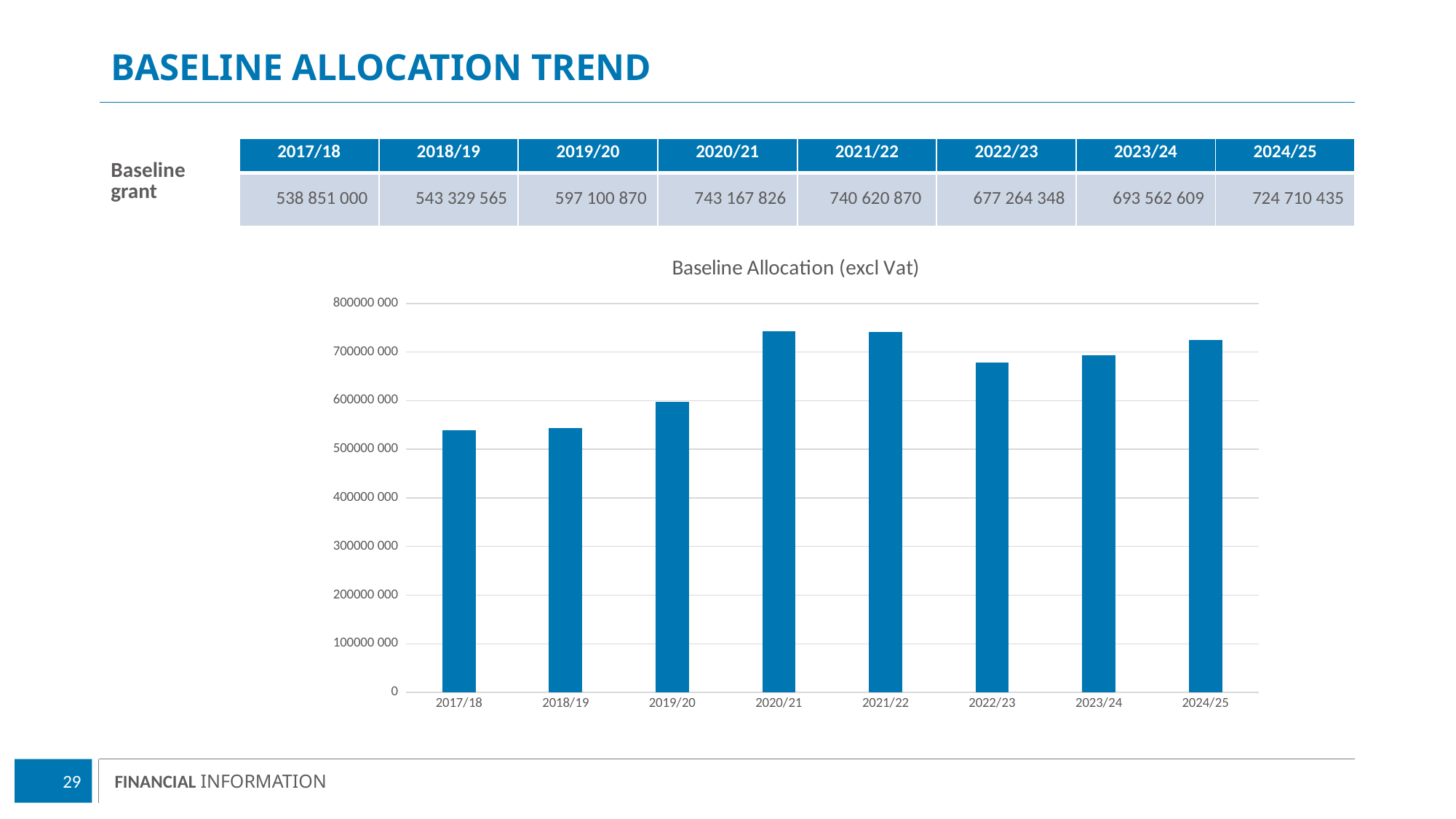
What is the baseline grant value for 2019/20? 597 100 870 Which year has the lowest baseline allocation? 2017/18 What is the difference between the baseline allocation for 2024/25 and 2023/24? 31 147 826 Which is larger, the baseline allocation for 2022/23 or for 2023/24? 2023/24 How many years are shown on the chart? 8 Is the value for 2022/23 greater or less than 700000 000? less What is the title of the chart? Baseline Allocation (excl Vat) What is the baseline grant value for 2022/23? 677 264 348 What is the difference between the baseline allocation for 2020/21 and 2017/18? 204 316 826 Which year has the highest baseline allocation? 2020/21 What kind of chart is shown on the slide? Bar chart What is the baseline grant value for 2024/25? 724 710 435